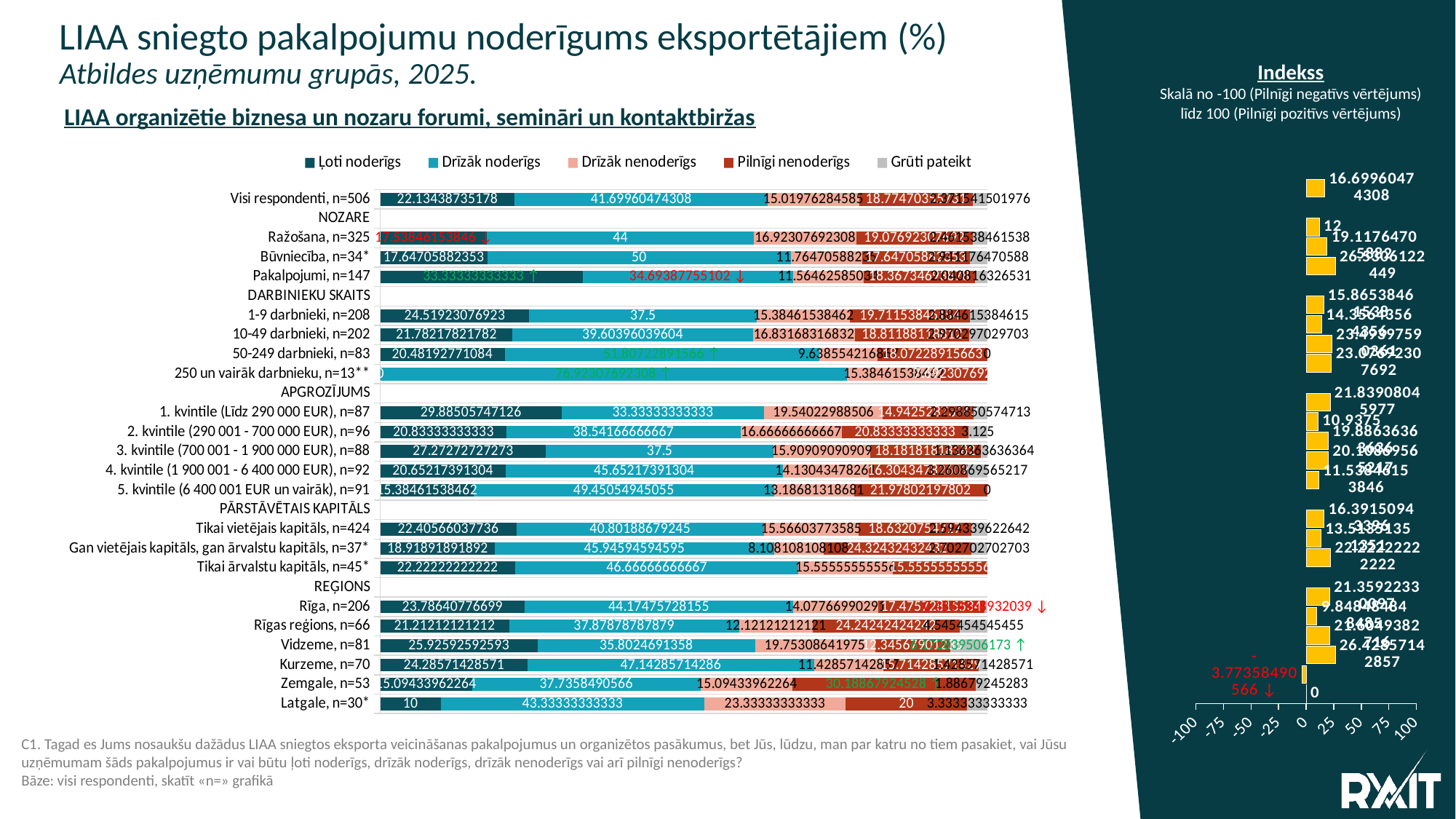
In the main chart, what is the difference between the 'Drīzāk noderīgs' value (43.33333333333) and the 'Ļoti noderīgs' value (10) for 'Latgale, n=30*'? 33.33333333333 In the 'Indekss' chart on the right, what is the index value for 'Zemgale, n=53'? -3.77358490566 In the main chart, which is larger: the 'Drīzāk noderīgs' value for 'Būvniecība, n=34*' or for 'Ražošana, n=325'? Būvniecība, n=34* In the main chart, what is the 'Drīzāk noderīgs' value for 'Būvniecība, n=34*'? 50 In the main chart, what is the 'Drīzāk noderīgs' value for 'Visi respondenti, n=506'? 41.69960474308 In the main chart, what is the 'Ļoti noderīgs' value for 'Latgale, n=30*'? 10 In the main chart, what is the 'Pilnīgi nenoderīgs' value for 'Latgale, n=30*'? 20 How many series does the legend of the main chart list? 5 In the main chart, which group has the highest 'Drīzāk noderīgs' value? 250 un vairāk darbnieku, n=13** What kind of chart is the main chart on the left of the slide? Stacked bar chart In the 'Indekss' chart on the right, what is the index value for 'Visi respondenti, n=506' (the top bar)? 16.69960474308